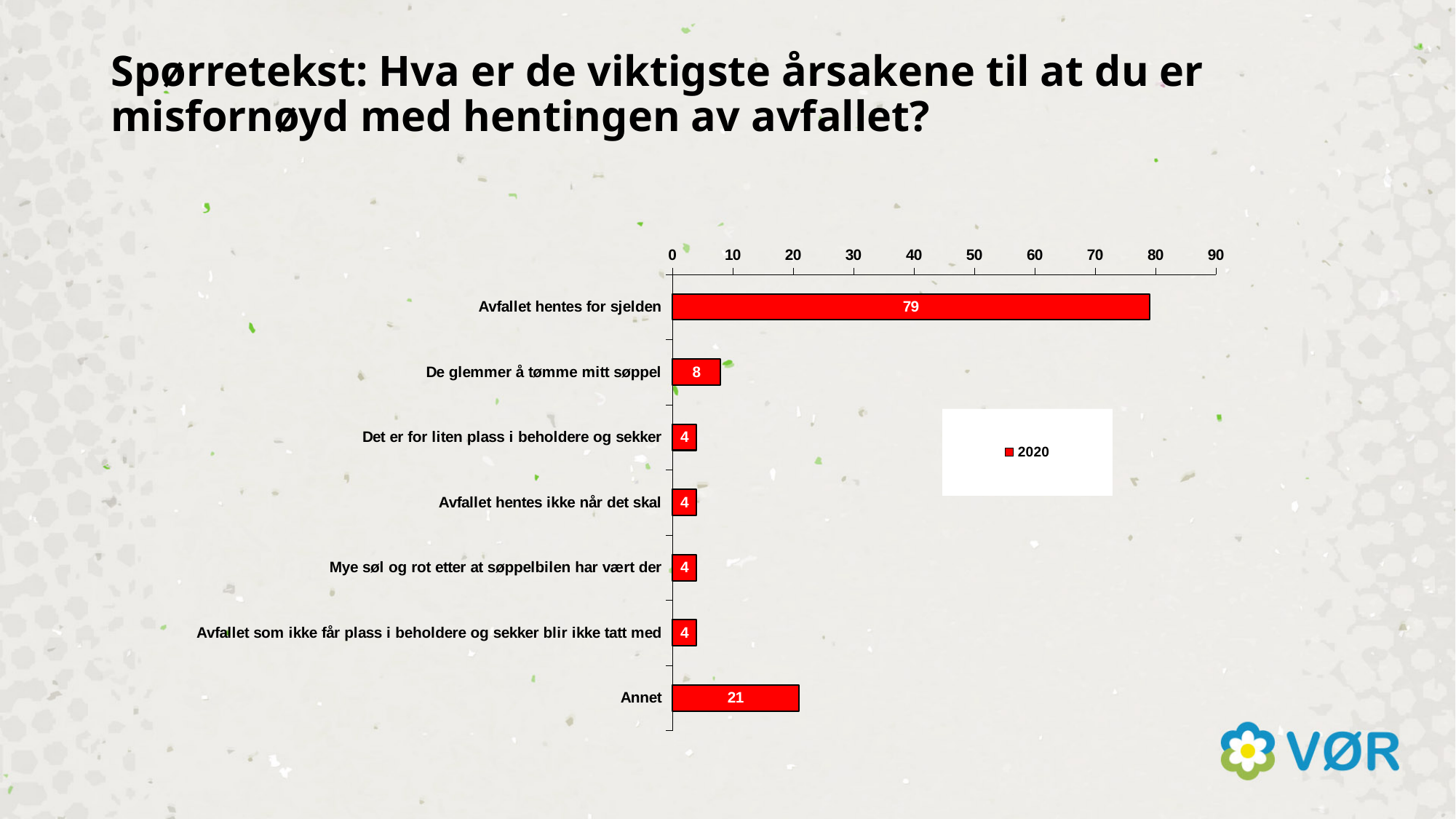
What is the value for "Avfallet hentes for sjelden"? 79 Is the value for "Avfallet hentes for sjelden" greater or less than 70? greater How many series does the legend list? 1 What is the difference between the values for "Annet" and "De glemmer å tømme mitt søppel"? 13 What is the value for "De glemmer å tømme mitt søppel"? 8 Which category has the highest value? Avfallet hentes for sjelden How many categories are shown in the chart? 7 What is the value for "Annet"? 21 Which is larger, the value for "Annet" or the value for "De glemmer å tømme mitt søppel"? Annet What is the value for "Det er for liten plass i beholdere og sekker"? 4 What is the difference between the values for "Avfallet hentes for sjelden" and "Annet"? 58 What kind of chart is shown on the slide? Bar chart